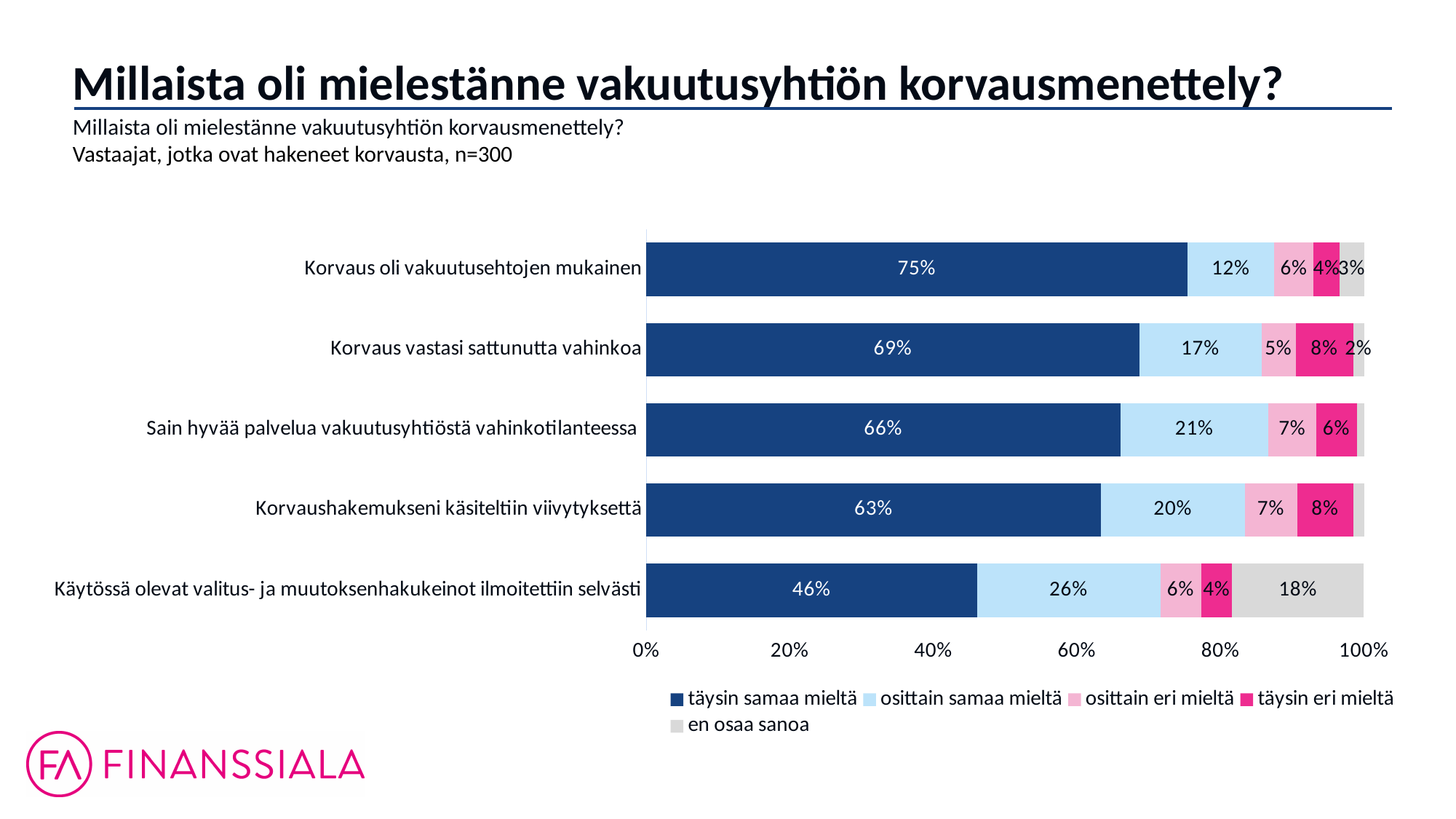
What kind of chart is shown on the slide? Stacked bar chart What is the sample size stated in the subtitle of the chart? n=300 What is the 'en osaa sanoa' value for 'Käytössä olevat valitus- ja muutoksenhakukeinot ilmoitettiin selvästi'? 18% Which statement has the highest 'täysin samaa mieltä' share? Korvaus oli vakuutusehtojen mukainen What is the 'täysin samaa mieltä' value for 'Korvaus oli vakuutusehtojen mukainen'? 75% What is the 'täysin eri mieltä' value for 'Korvaushakemukseni käsiteltiin viivytyksettä'? 8% What is the difference in 'täysin samaa mieltä' share between 'Korvaus oli vakuutusehtojen mukainen' and 'Käytössä olevat valitus- ja muutoksenhakukeinot ilmoitettiin selvästi'? 29 percentage points How many series does the legend list? 5 How many statements (categories) are shown in the chart? 5 What is the 'osittain samaa mieltä' value for 'Käytössä olevat valitus- ja muutoksenhakukeinot ilmoitettiin selvästi'? 26% Which is larger: the 'osittain samaa mieltä' share for 'Sain hyvää palvelua vakuutusyhtiöstä vahinkotilanteessa' or for 'Korvaus vastasi sattunutta vahinkoa'? Sain hyvää palvelua vakuutusyhtiöstä vahinkotilanteessa Which statement has the lowest 'täysin samaa mieltä' share? Käytössä olevat valitus- ja muutoksenhakukeinot ilmoitettiin selvästi